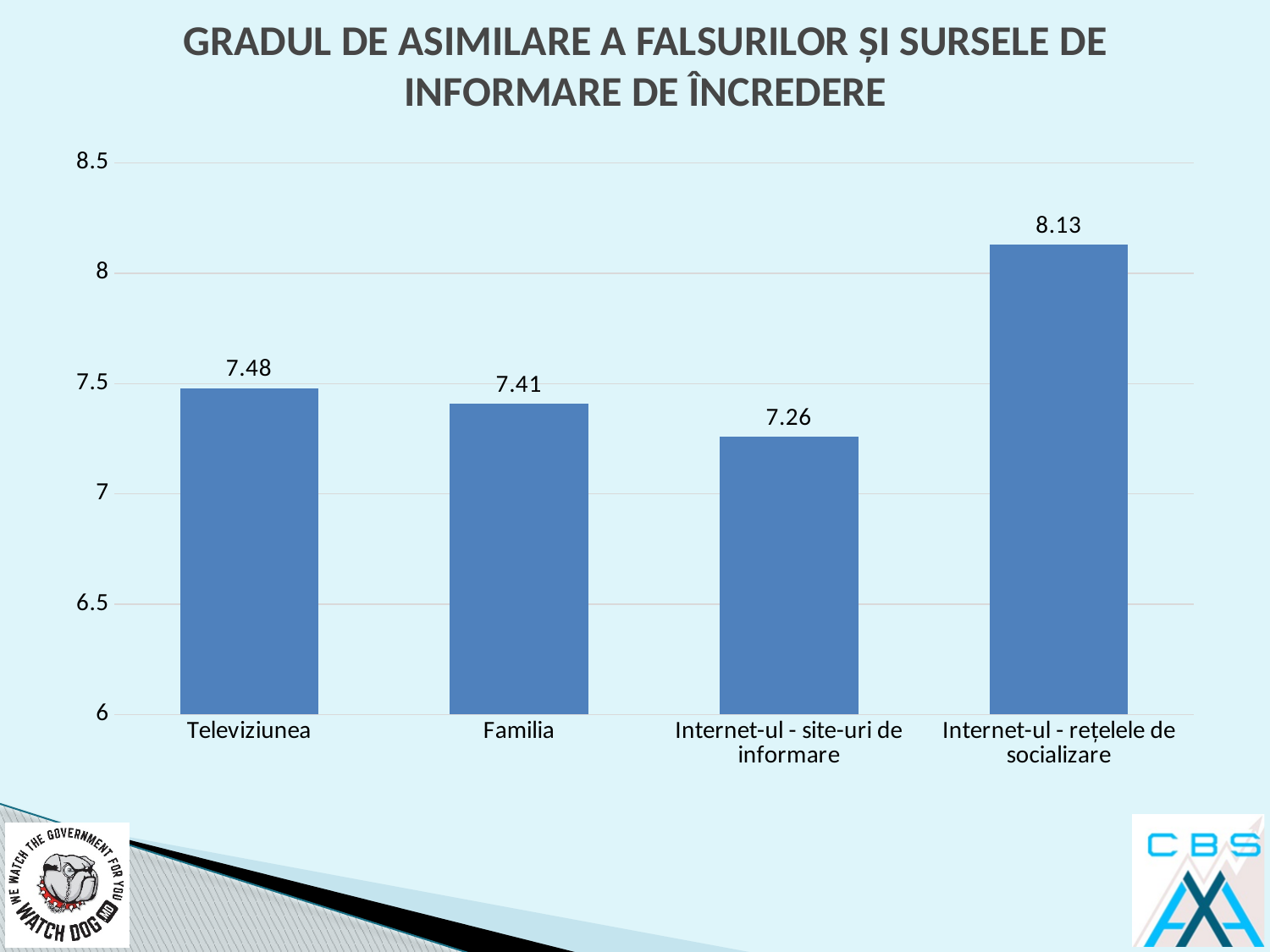
Which category has the highest value? Internet-ul - rețelele de socializare How many categories are shown in the chart? 4 What is the value for Televiziunea? 7.48 What is the value for Internet-ul - site-uri de informare? 7.26 What is the value for Internet-ul - rețelele de socializare? 8.13 Which is larger, the value for Televiziunea or the value for Internet-ul - site-uri de informare? Televiziunea Is the value for Internet-ul - rețelele de socializare greater or less than 8? greater What is the value for Familia? 7.41 What is the difference between the values for Familia and Internet-ul - site-uri de informare? 0.15 What is the difference between the values for Internet-ul - rețelele de socializare and Televiziunea? 0.65 What kind of chart is shown on the slide? bar chart Which category has the lowest value? Internet-ul - site-uri de informare